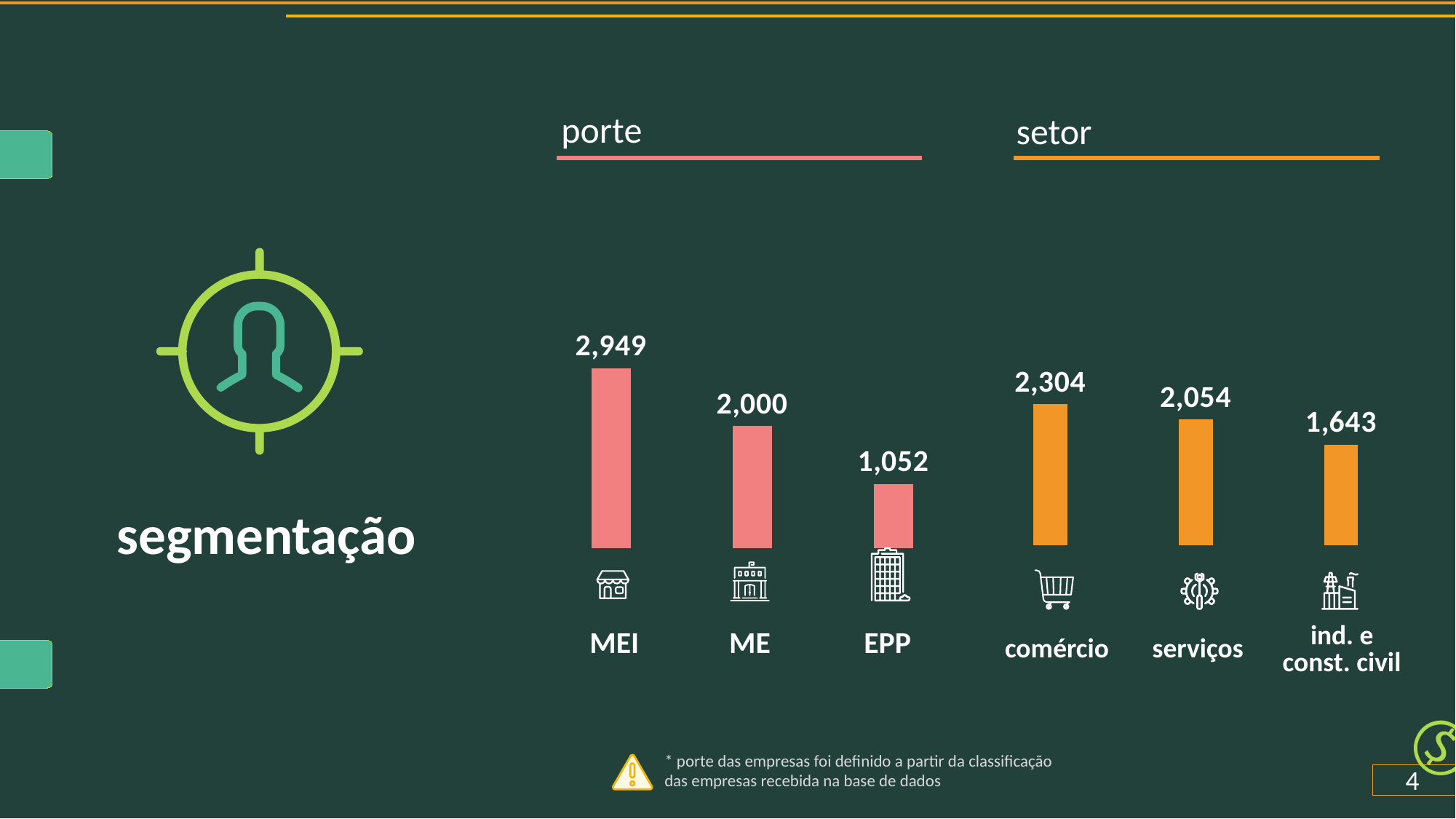
In the 'setor' chart, which category has the lowest value? ind. e const. civil In the 'setor' chart, what is the value for ind. e const. civil? 1,643 In the 'setor' chart, what is the value for serviços? 2,054 What kind of chart is the 'setor' chart? bar chart In the 'setor' chart, which is larger, the value for comércio or the value for ind. e const. civil? comércio In the 'setor' chart, what is the difference between the values for comércio and serviços? 250 How many categories does the 'porte' chart show? 3 In the 'porte' chart, what is the value for EPP? 1,052 In the 'porte' chart, which category has the highest value? MEI In the 'porte' chart, what is the value for MEI? 2,949 In the 'porte' chart, do the values rise or fall from MEI to EPP? fall In the 'porte' chart, what is the difference between the values for MEI and ME? 949